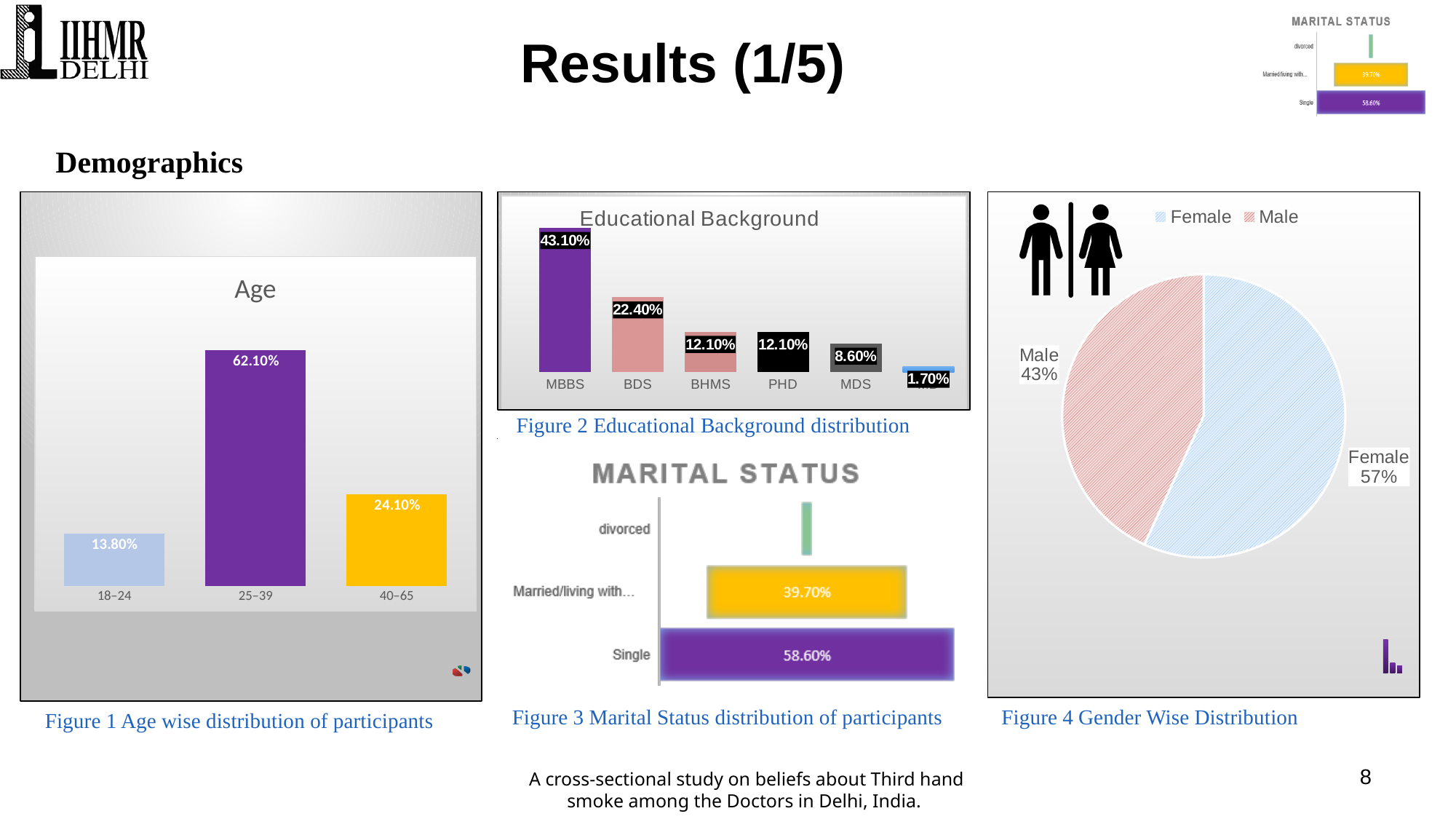
In the Educational Background chart (Figure 2), what is the value for MBBS? 43.10% In the Age chart (Figure 1), what is the difference between the values for 25–39 and 40–65? 38.00% How many age groups are shown in the Age chart (Figure 1)? 3 In the Marital Status chart (Figure 3), what is the value for Single? 58.60% What kind of chart is the Gender Wise Distribution chart (Figure 4)? pie chart In the Age chart (Figure 1), which age group has the lowest value? 18–24 In the Educational Background chart (Figure 2), what is the difference between the values for MBBS and BDS? 20.70% In the Age chart (Figure 1), what is the value for the 25–39 age group? 62.10% In the Gender Wise Distribution chart (Figure 4), what share of the pie is Female? 57% In the Marital Status chart (Figure 3), what is the difference between the values for Single and Married/living with…? 18.90% In the Educational Background chart (Figure 2), which is larger, the value for BDS or the value for MDS? BDS In the Educational Background chart (Figure 2), which category has the highest value? MBBS